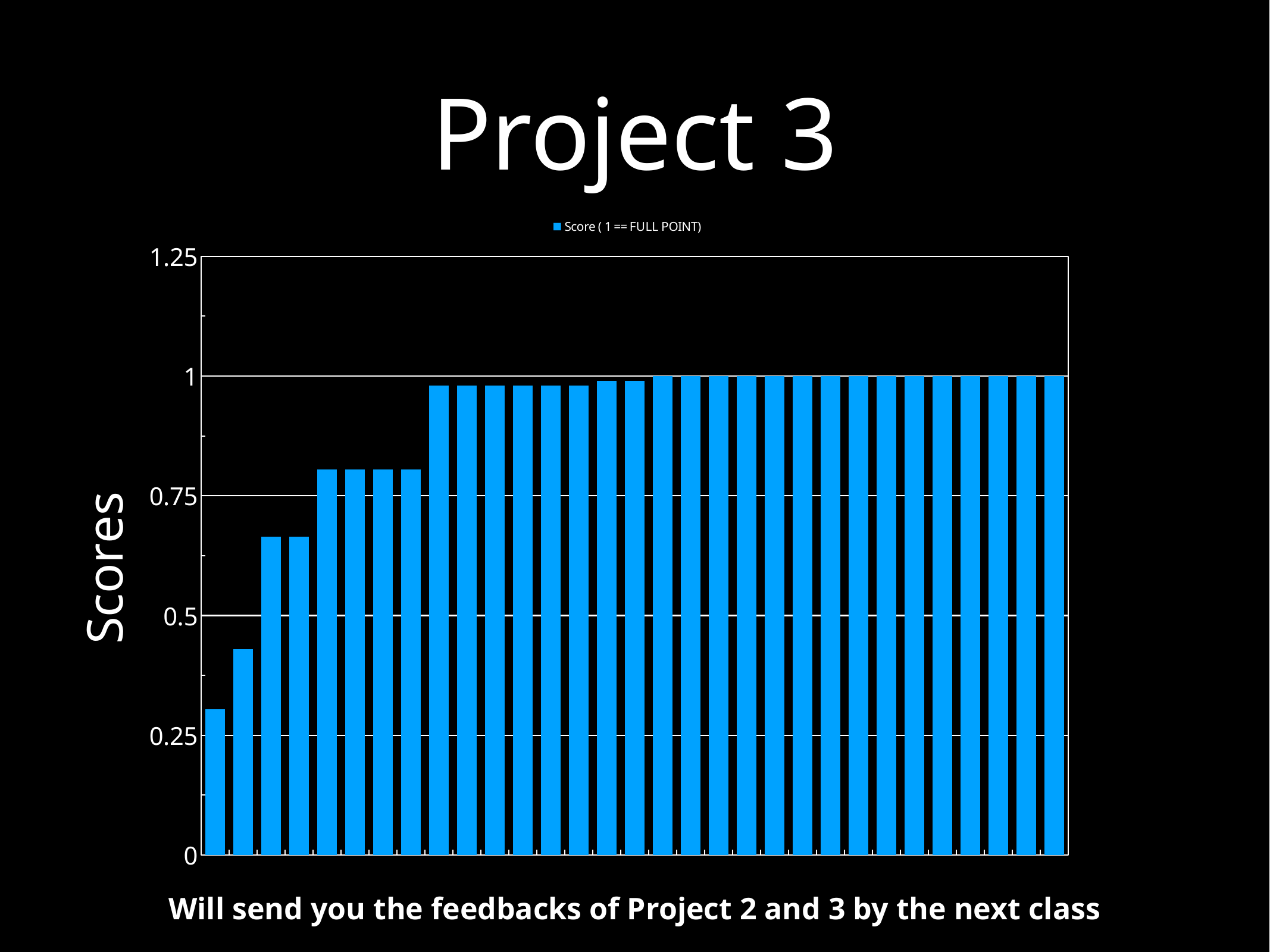
Is the value of the leftmost bar greater or less than 0.5? less Which bar has the lowest value in the chart? the leftmost bar How many series does the legend list? 1 What is the label on the vertical axis of the chart? Scores What kind of chart is shown on the slide? bar chart Is the value of the third bar from the left greater or less than 0.5? greater Is the value of the fifth bar from the left greater or less than 0.75? greater What is the highest value shown on the vertical axis? 1.25 Do the bar values rise or fall from left to right along the x axis? rise Which is larger, the leftmost bar or the rightmost bar? the rightmost bar What is the legend entry for the series in the chart? Score ( 1 == FULL POINT)